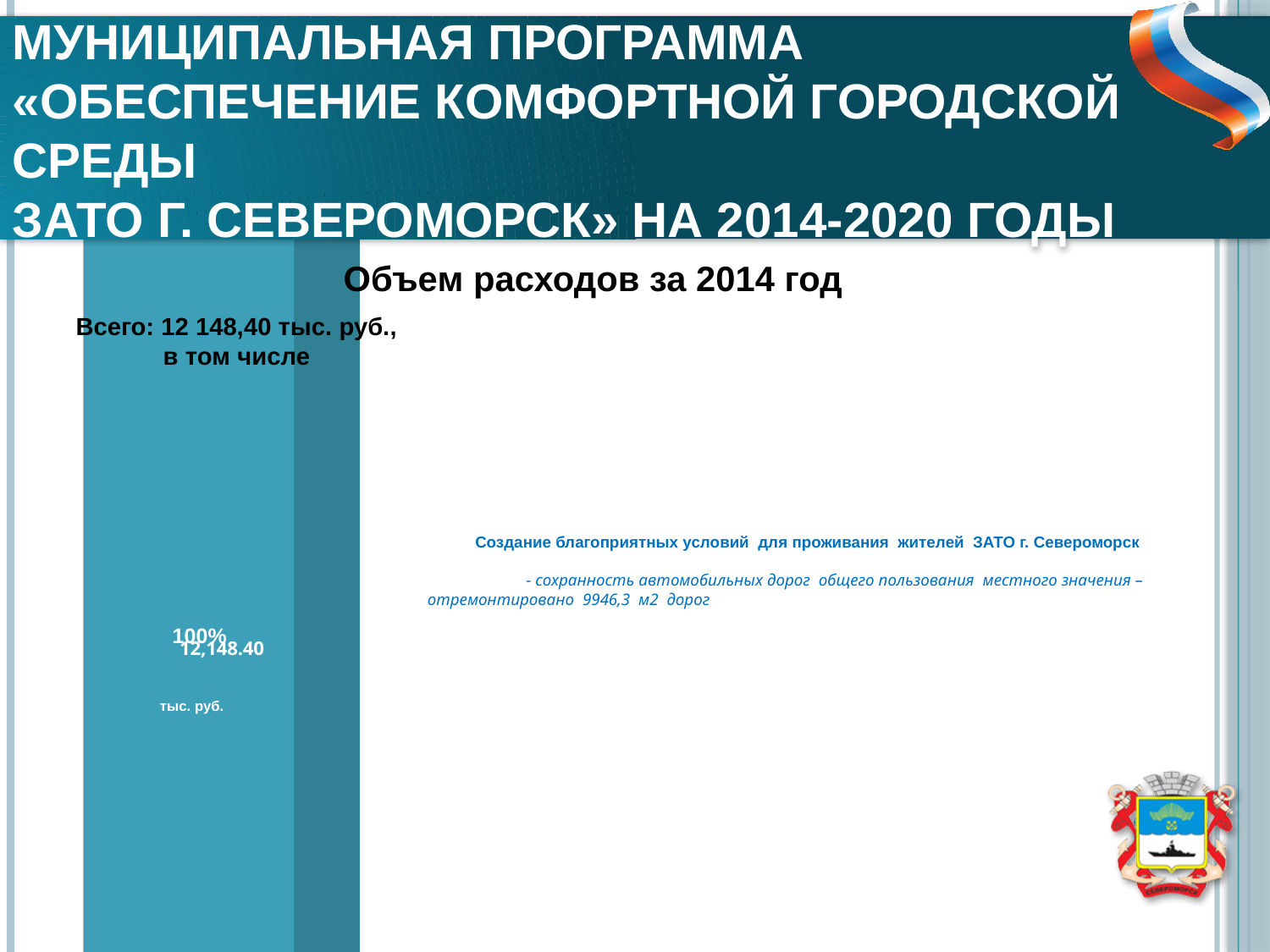
What unit is shown below the value on the bar? тыс. руб. How many bars does the chart contain? 1 What is the title of the chart? Объем расходов за 2014 год What kind of chart is shown on the slide? bar chart What percentage is printed on the bar in the chart? 100% What value is printed on the bar in the chart? 12,148.40